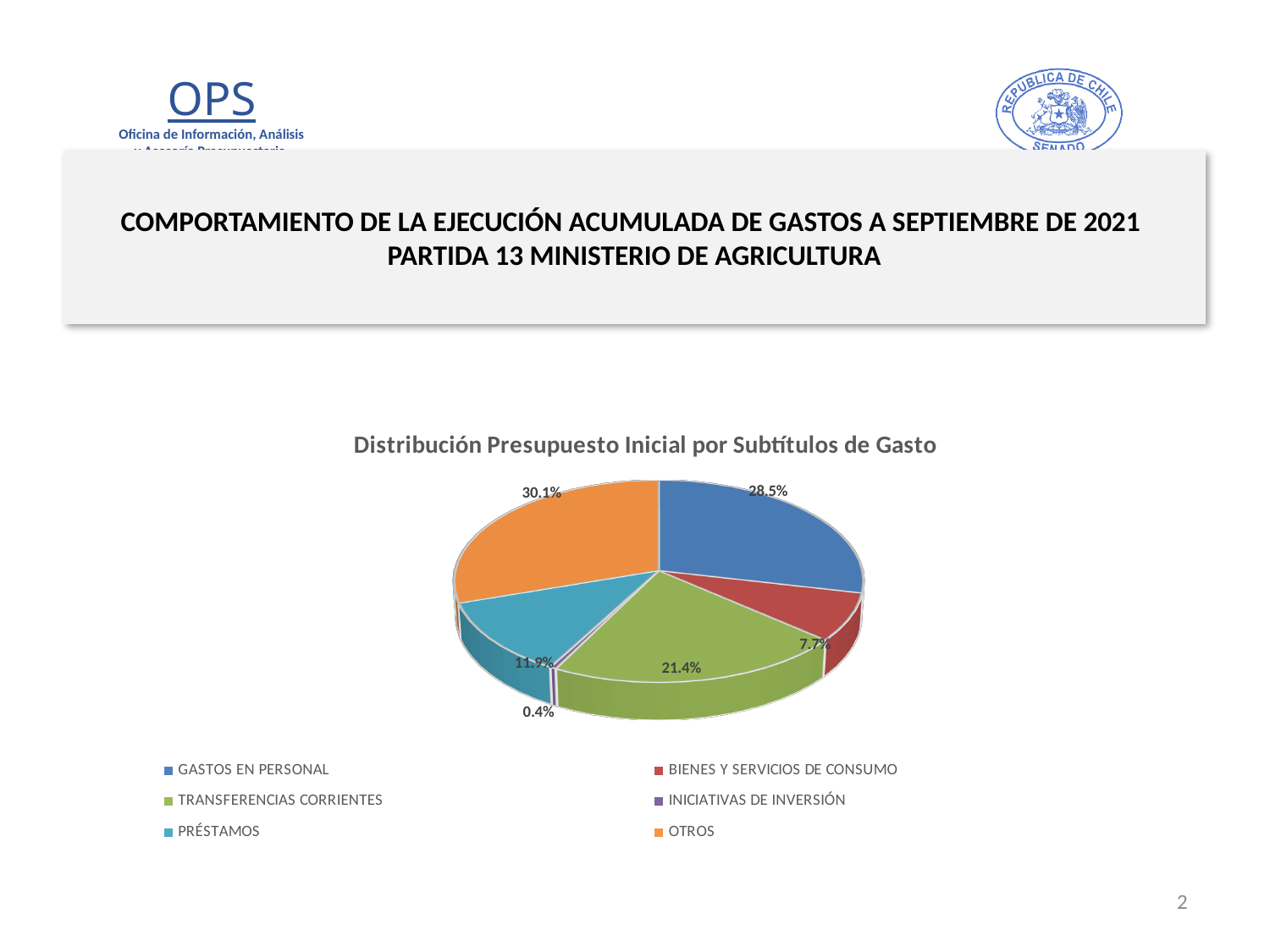
What is the difference in percentage points between the shares of GASTOS EN PERSONAL and BIENES Y SERVICIOS DE CONSUMO? 20.8 What share of the pie does OTROS represent? 30.1% What share of the pie does GASTOS EN PERSONAL represent? 28.5% Which has a larger share, TRANSFERENCIAS CORRIENTES or PRÉSTAMOS? TRANSFERENCIAS CORRIENTES What kind of chart is shown on the slide? Pie chart How many categories does the legend list? 6 What share of the pie does TRANSFERENCIAS CORRIENTES represent? 21.4% What is the title of the chart? Distribución Presupuesto Inicial por Subtítulos de Gasto Which category has the smallest share of the pie? INICIATIVAS DE INVERSIÓN Which category has the largest share of the pie? OTROS